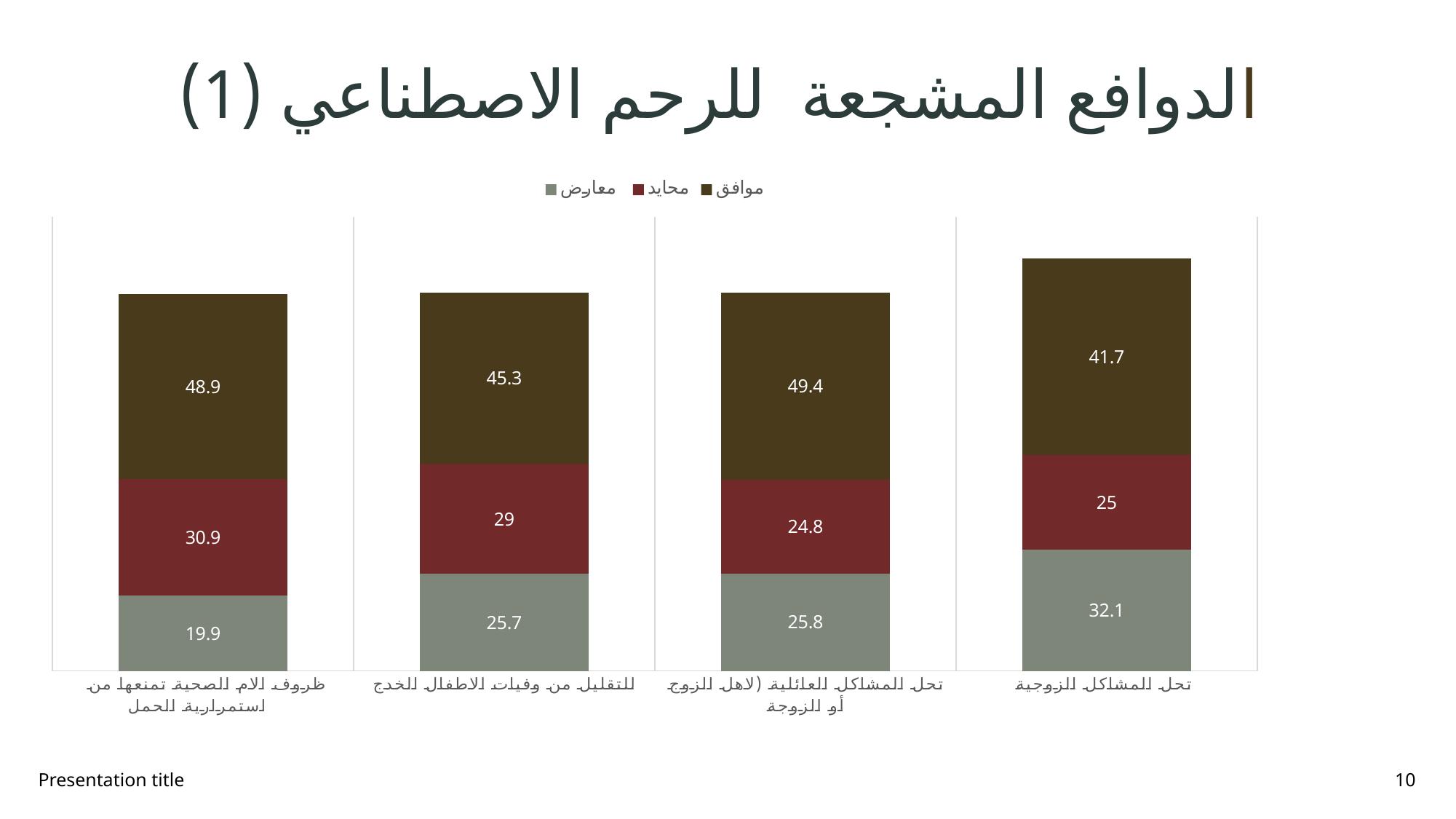
What is the value of محايد for للتقليل من وفيات الاطفال الخدج? 29 What is the value of معارض for ظروف الام الصحية تمنعها من استمرارية الحمل? 19.9 What is the total of the stacked bar for تحل المشاكل الزوجية? 98.8 Which is larger: the محايد value for ظروف الام الصحية تمنعها من استمرارية الحمل or for تحل المشاكل الزوجية? ظروف الام الصحية تمنعها من استمرارية الحمل Which category has the highest موافق value? تحل المشاكل العائلية (اهل الزوج أو الزوجة) How many categories are shown on the x axis? 4 What is the difference between the موافق values for تحل المشاكل العائلية (اهل الزوج أو الزوجة) and تحل المشاكل الزوجية? 7.7 How many series does the legend list? 3 Which category has the lowest معارض value? ظروف الام الصحية تمنعها من استمرارية الحمل What type of chart is shown on the slide? Stacked bar chart What is the value of موافق for تحل المشاكل الزوجية? 41.7 Which legend entry is shown in grey? معارض